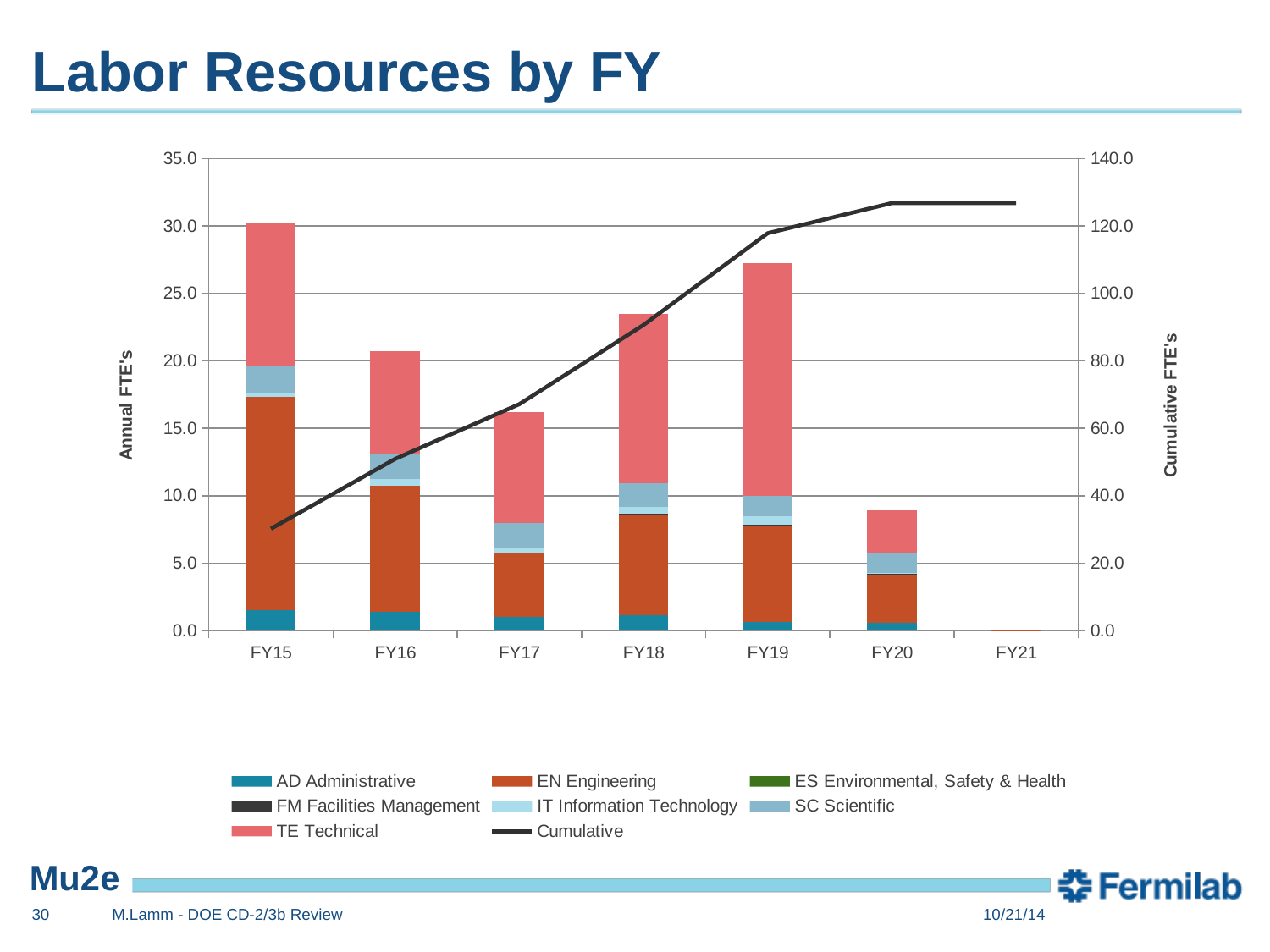
Among FY15 through FY20, which fiscal year has the shortest stacked bar? FY20 What is the title of the chart? Labor Resources by FY Which fiscal year has the tallest stacked bar (highest annual FTE's)? FY15 Is the total annual FTE's bar for FY15 greater or less than 25.0? greater Is the Cumulative line value at FY20 greater or less than 120.0 on the right axis? greater How many entries does the legend list? 8 Does the Cumulative line rise or fall from FY15 to FY19? rise Is the total annual FTE's bar for FY17 greater or less than 20.0? less Which fiscal year has the taller stacked bar, FY18 or FY19? FY19 What is the label on the right-hand vertical axis? Cumulative FTE's What kind of chart is shown on the slide? Stacked bar chart with a line How many fiscal years are shown on the x axis? 7